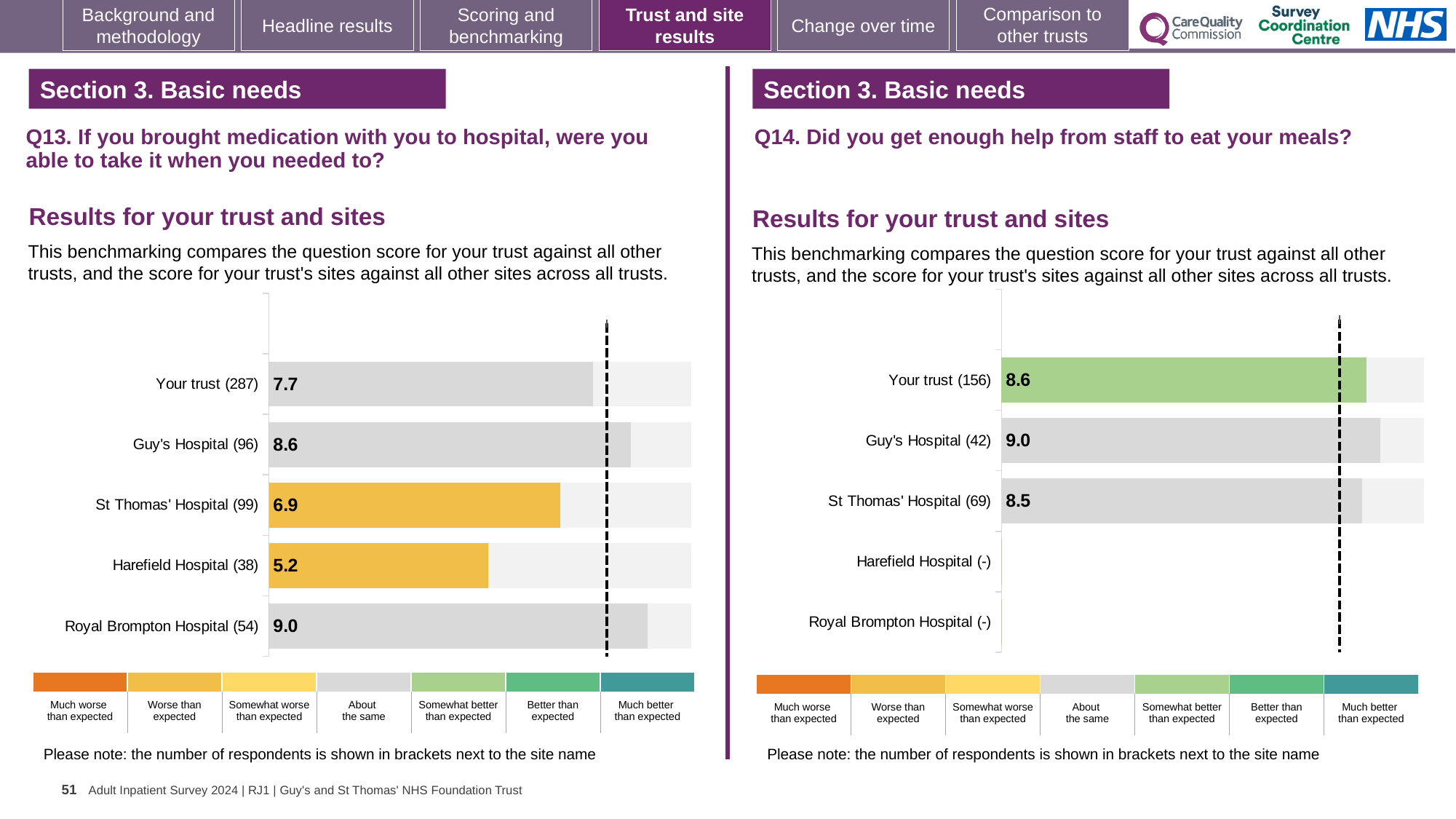
In the Q13 chart on the left, what is the difference between the scores for Guy's Hospital (96) and St Thomas' Hospital (99)? 1.7 What type of chart is used on this slide? Bar chart In the Q13 chart on the left, which site has the lowest score? Harefield Hospital (38) In the Q14 chart on the right, what is the difference between the scores for Guy's Hospital (42) and St Thomas' Hospital (69)? 0.5 In the Q13 chart on the left, what is the score for Harefield Hospital (38)? 5.2 In the Q14 chart on the right, what is the score for Your trust (156)? 8.6 In the Q14 chart on the right, which site has the highest score? Guy's Hospital (42) In the Q13 chart on the left, which site has the highest score? Royal Brompton Hospital (54) In the Q13 chart on the left, what is the score for Your trust (287)? 7.7 In the Q14 chart on the right, what is the score for St Thomas' Hospital (69)? 8.5 In the Q13 chart on the left, which has the larger score, Your trust (287) or Guy's Hospital (96)? Guy's Hospital (96) How many bars with a score are plotted in the Q14 chart on the right? 3